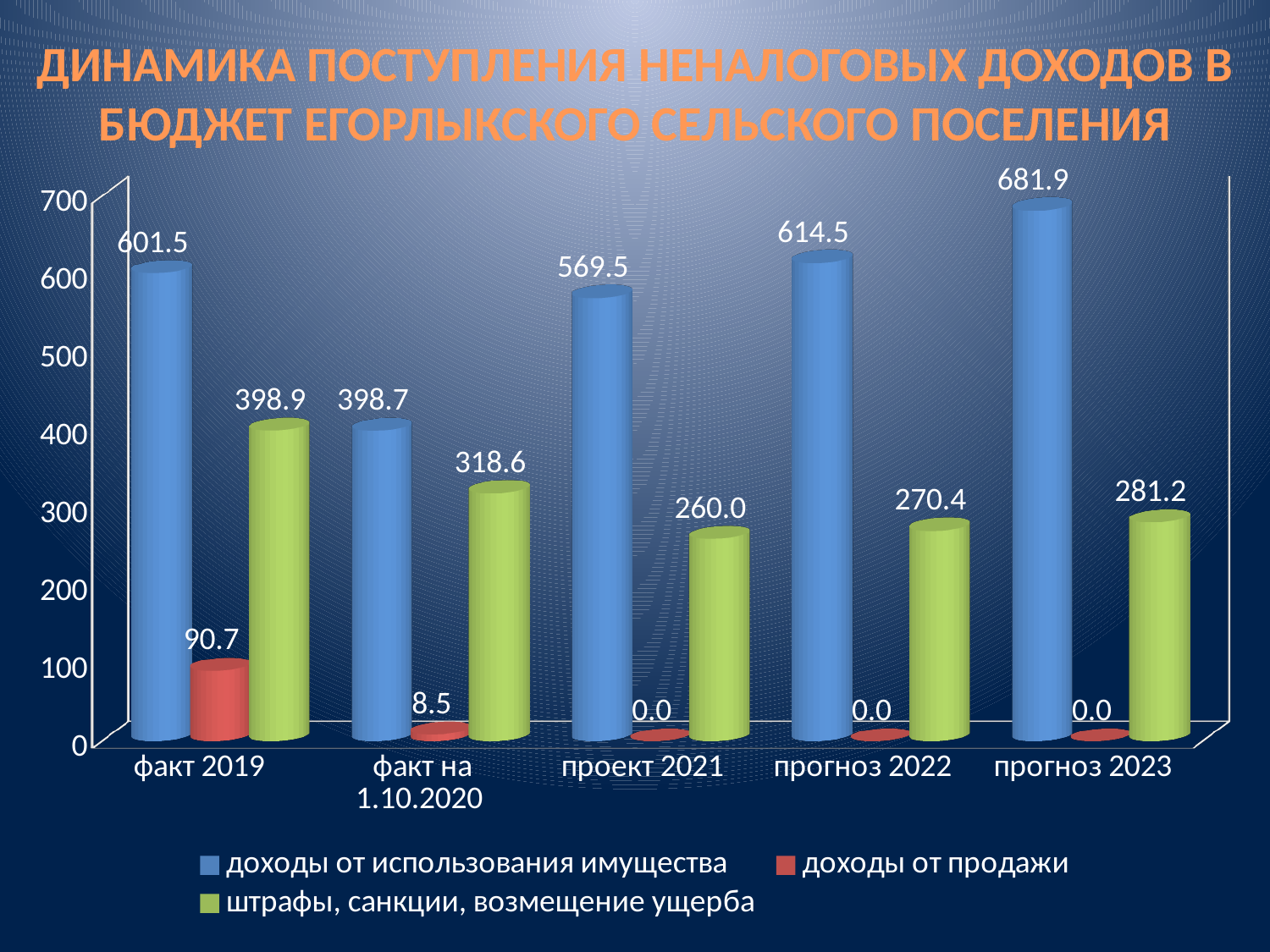
What is the value for доходы от использования имущества in прогноз 2023? 681.9 What is the difference between доходы от использования имущества in прогноз 2023 and in прогноз 2022? 67.4 Which colour represents доходы от продажи in the chart? red In which category is доходы от использования имущества the lowest? факт на 1.10.2020 In which category is доходы от использования имущества the highest? прогноз 2023 What kind of chart is shown on the slide? bar chart What is the value for доходы от продажи in факт 2019? 90.7 What is the value for штрафы, санкции, возмещение ущерба in факт на 1.10.2020? 318.6 How many categories are shown on the x axis? 5 How many series does the legend list? 3 Which is larger: штрафы, санкции, возмещение ущерба in факт 2019 or доходы от использования имущества in факт на 1.10.2020? штрафы, санкции, возмещение ущерба in факт 2019 Does the value for доходы от использования имущества rise or fall from проект 2021 to прогноз 2023? rise